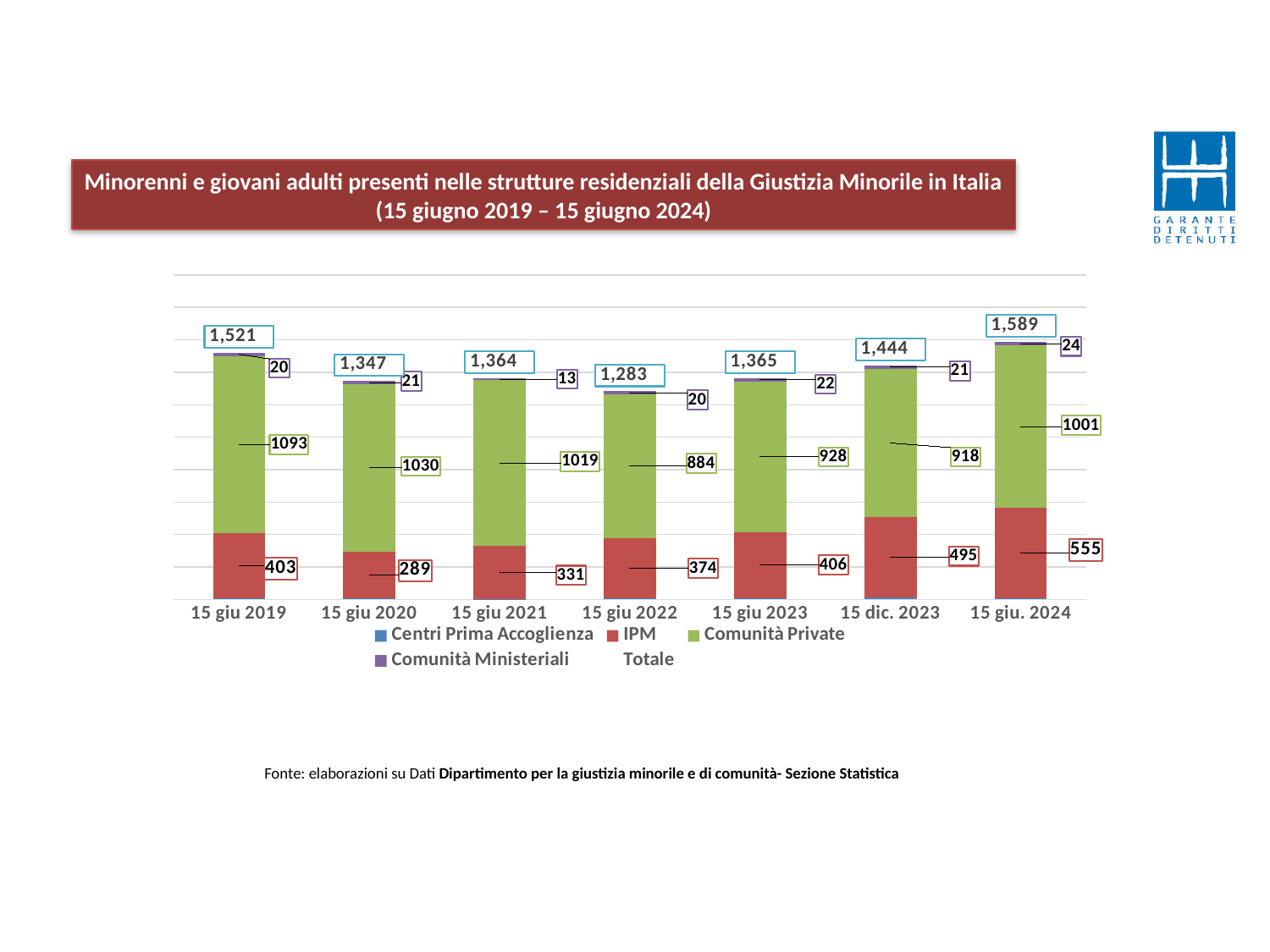
What is the Comunità Ministeriali value for 15 giu 2021? 13 Which date has the highest IPM value? 15 giu. 2024 How many series does the legend list? 5 What is the Totale value shown for 15 giu. 2024? 1,589 What kind of chart is shown on the slide? Stacked bar chart What is the Comunità Private value for 15 giu 2022? 884 Which date has the lowest Totale value? 15 giu 2022 What is the difference between the IPM values for 15 giu. 2024 and 15 giu 2020? 266 What is the IPM value for 15 giu 2019? 403 Which is larger, the Comunità Private value for 15 giu 2023 or for 15 dic. 2023? 15 giu 2023 Which series is shown in green in the chart? Comunità Private How many dates are shown on the x axis? 7